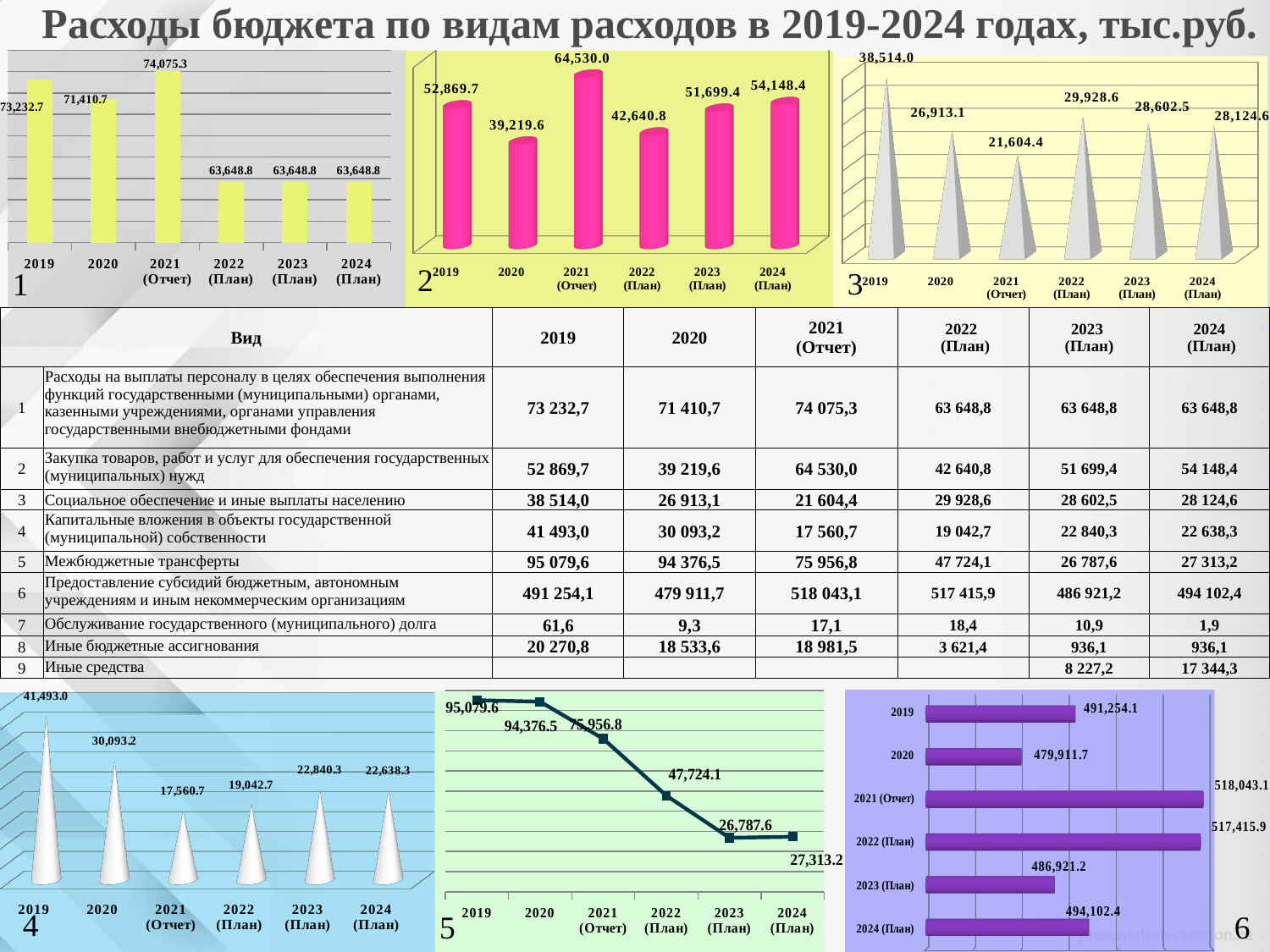
How many years are plotted in chart 6 (bottom-right)? 6 In chart 6 (bottom-right), which year has the highest value? 2021 (Отчет) In chart 1 (top-left), what is the value for 2021 (Отчет)? 74,075.3 In chart 4 (bottom-left), is the value for 2022 (План) larger or smaller than the value for 2023 (План)? smaller In chart 2 (top-middle), what is the value for 2020? 39,219.6 What kind of chart is chart 5 (bottom-middle)? line chart In chart 3 (top-right), what is the value for 2019? 38,514.0 In chart 5 (bottom-middle), do the values generally rise or fall from 2019 to 2023 (План)? fall In chart 1 (top-left), which year has the highest value? 2021 (Отчет) In chart 4 (bottom-left), what is the value for 2020? 30,093.2 In chart 2 (top-middle), what is the difference between the 2021 (Отчет) value and the 2020 value? 25,310.4 In chart 3 (top-right), which year has the lowest value? 2021 (Отчет)